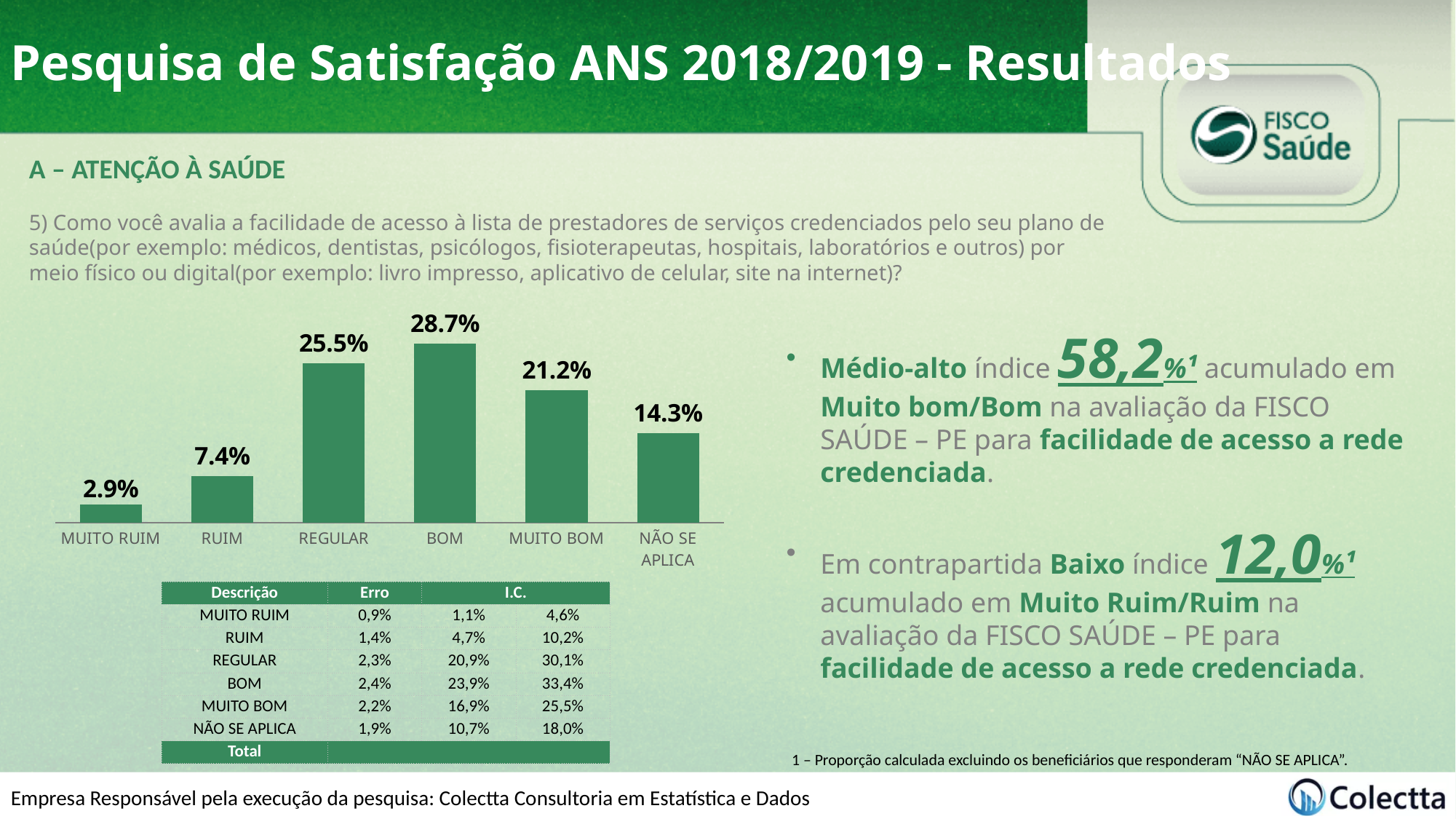
What colour are the bars in the chart? Green How many categories are shown in the bar chart? 6 What is the value for MUITO BOM in the bar chart? 21.2% What kind of chart is shown on the slide? Bar chart Which is larger, the value for REGULAR or the value for MUITO BOM? REGULAR What is the value for NÃO SE APLICA in the bar chart? 14.3% What is the difference between the values for BOM and MUITO BOM? 7.5% What is the difference between the values for RUIM and MUITO RUIM? 4.5% Which category has the highest value in the bar chart? BOM What is the value for REGULAR in the bar chart? 25.5% What is the value for MUITO RUIM in the bar chart? 2.9% Which category has the lowest value in the bar chart? MUITO RUIM